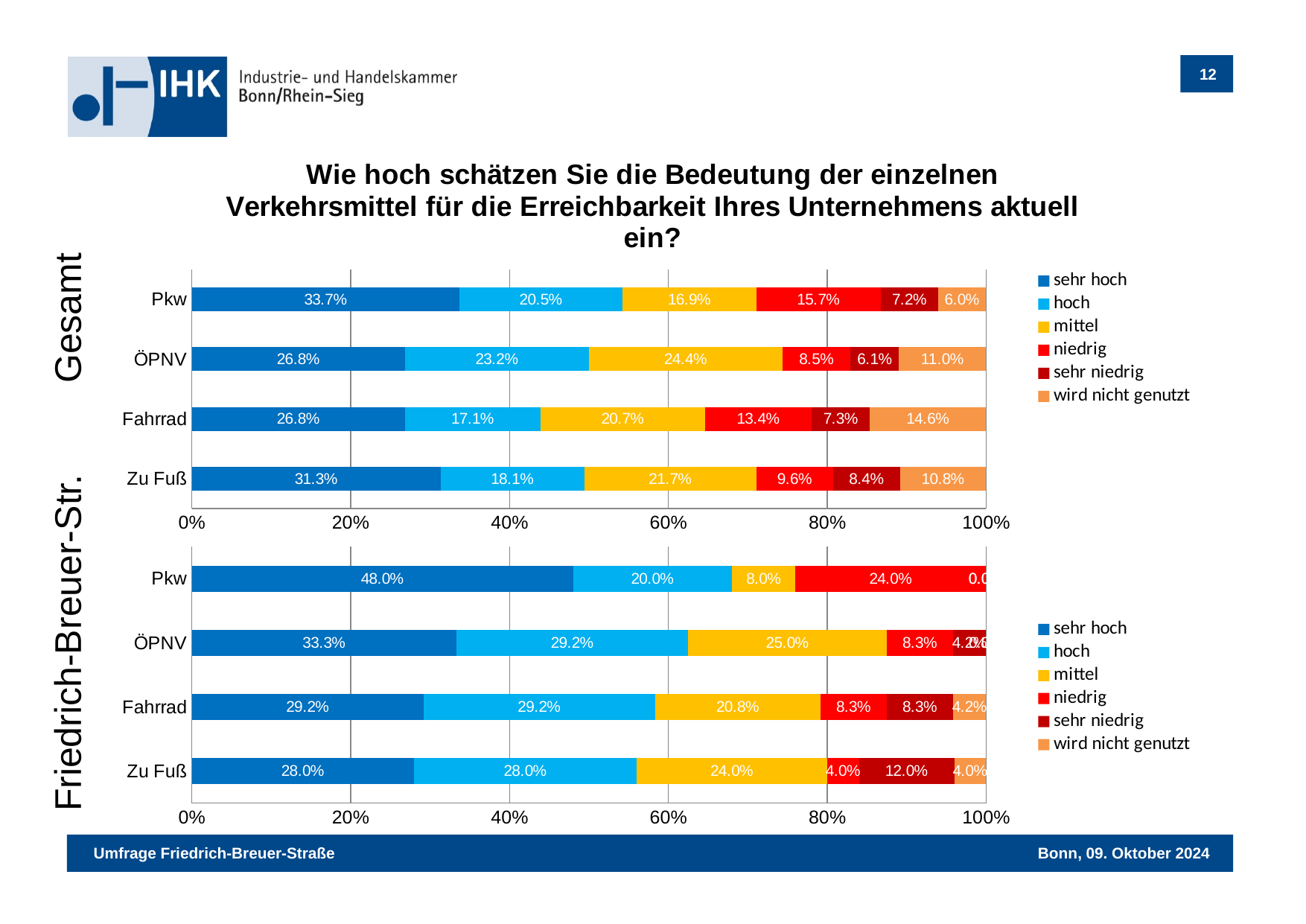
How many categories are shown in the Friedrich-Breuer-Str. chart? 4 What kind of chart is the Gesamt chart? Stacked bar chart In the Friedrich-Breuer-Str. chart, what is the 'sehr hoch' value for Pkw? 48.0% In the Friedrich-Breuer-Str. chart, which category has the highest 'niedrig' value? Pkw In the Gesamt chart, what is the difference between the 'mittel' values for ÖPNV and Pkw? 7.5% In the Gesamt chart, is the 'niedrig' value larger for Pkw or for Zu Fuß? Pkw In the Gesamt chart, which category has the lowest 'wird nicht genutzt' value? Pkw In the Gesamt chart, which category has the highest 'sehr hoch' value? Pkw In the Gesamt chart, what is the 'sehr hoch' value for Pkw? 33.7% In the Friedrich-Breuer-Str. chart, what is the 'sehr niedrig' value for Zu Fuß? 12.0% In the Gesamt chart, what is the 'wird nicht genutzt' value for Fahrrad? 14.6% How many series does the legend of the Gesamt chart list? 6